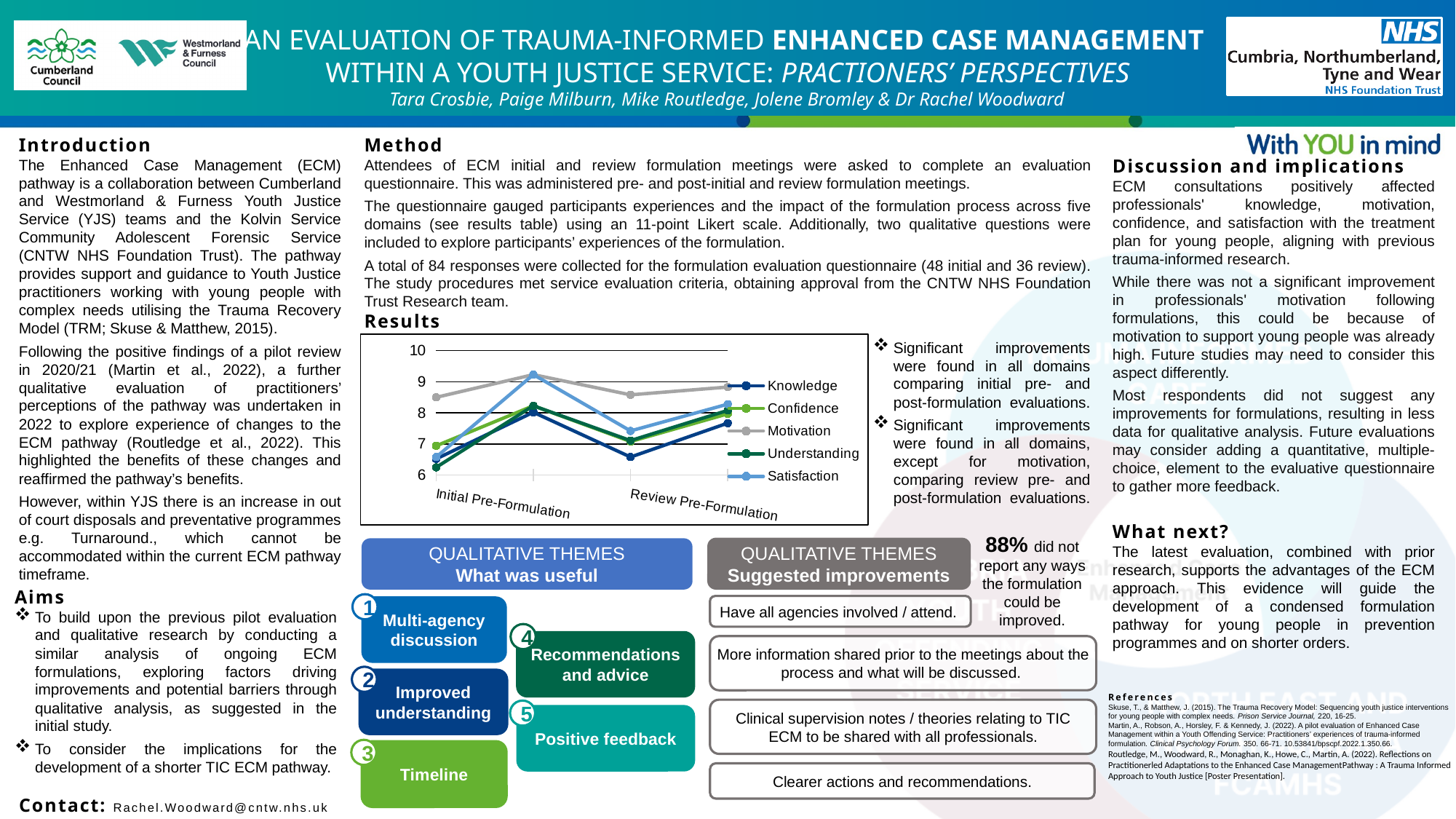
In the Results chart, is the value for Motivation at Review Pre-Formulation greater or less than 8? greater How many series does the legend of the Results chart list? 5 What kind of chart is shown in the Results section? line chart Which series are listed in the legend of the Results chart? Knowledge, Confidence, Motivation, Understanding, Satisfaction In the Results chart, is the value for Knowledge at Review Pre-Formulation greater or less than 7? less In the Results chart, which is larger at Review Pre-Formulation: Motivation or Understanding? Motivation In the Results chart, do the values for Knowledge rise or fall from Initial Pre-Formulation to the next point? rise In the Results chart, which series has the highest value at Initial Pre-Formulation? Motivation What is the range of the y axis on the Results chart? 6 to 10 In the Results chart, is the value for Motivation at Initial Pre-Formulation greater or less than 8? greater In the Results chart, which is larger at Initial Pre-Formulation: Motivation or Knowledge? Motivation